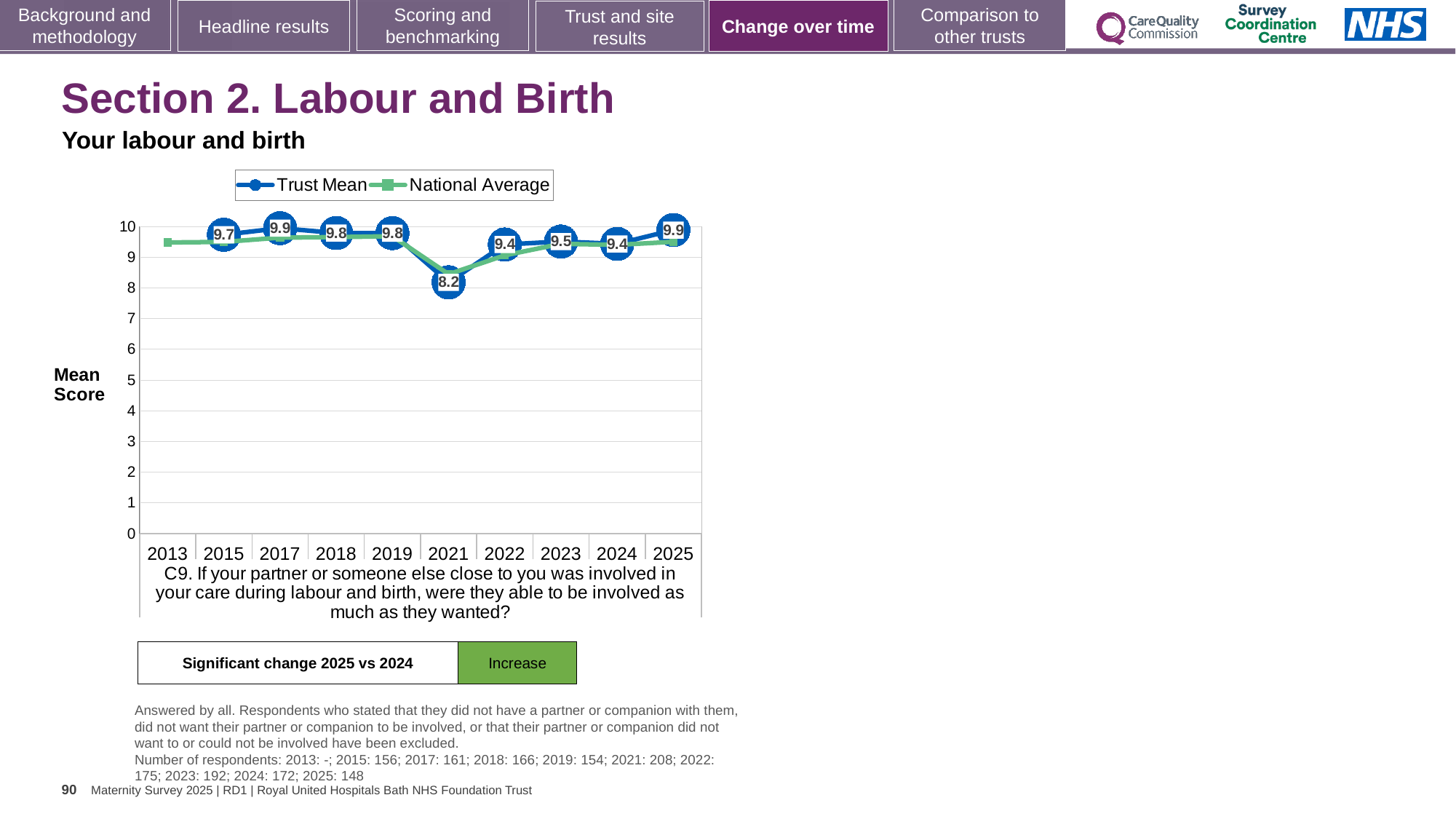
What is the Trust Mean score for 2015? 9.7 What is the Trust Mean score for 2025? 9.9 What kind of chart is shown on the slide? line chart How many series does the legend list? 2 How many years are shown on the x axis? 10 What is the Trust Mean score for 2021? 8.2 Which year has the larger Trust Mean score, 2021 or 2022? 2022 In which year is the Trust Mean score lowest? 2021 Is the National Average value for 2021 greater or less than 9? less Does the Trust Mean score rise or fall from 2021 to 2025? rise What is the label on the y axis of the chart? Mean Score What is the difference between the Trust Mean scores for 2025 and 2024? 0.5